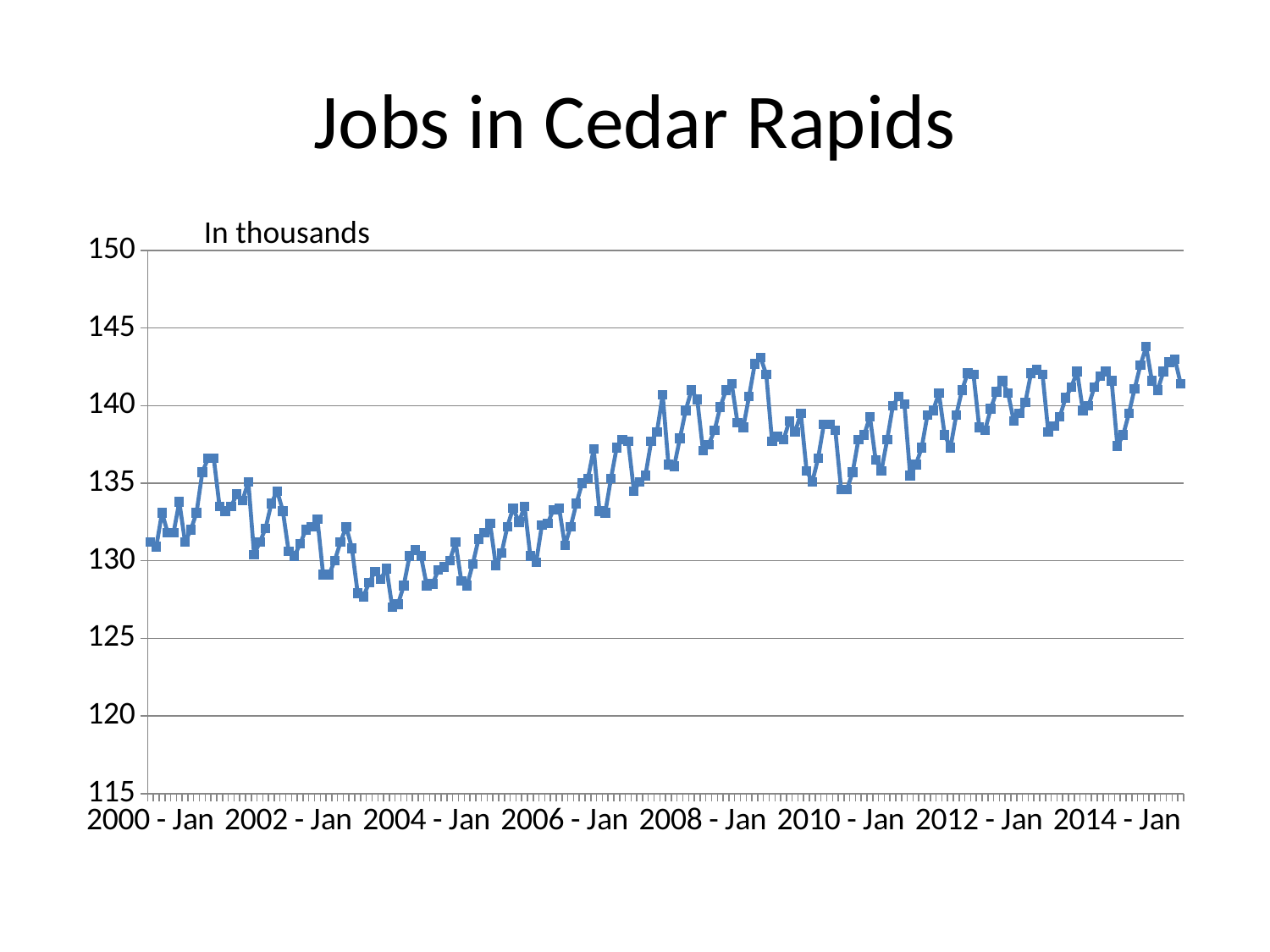
Which is larger, the value at 2000 - Jan or the value at 2014 - Jan? 2014 - Jan Which is larger, the value at 2004 - Jan or the value at 2008 - Jan? 2008 - Jan Is the value at 2006 - Jan greater or less than 135? less What kind of chart is shown on the slide? line chart Is the value at 2008 - Jan greater or less than 135? greater Overall, does the line rise or fall from 2000 - Jan to 2014 - Jan? rise How many lines are plotted on the chart? 1 In what units are the values on the chart expressed, according to the note above the plot? In thousands Is the value at 2004 - Jan greater or less than 130? less What is the title of the chart? Jobs in Cedar Rapids